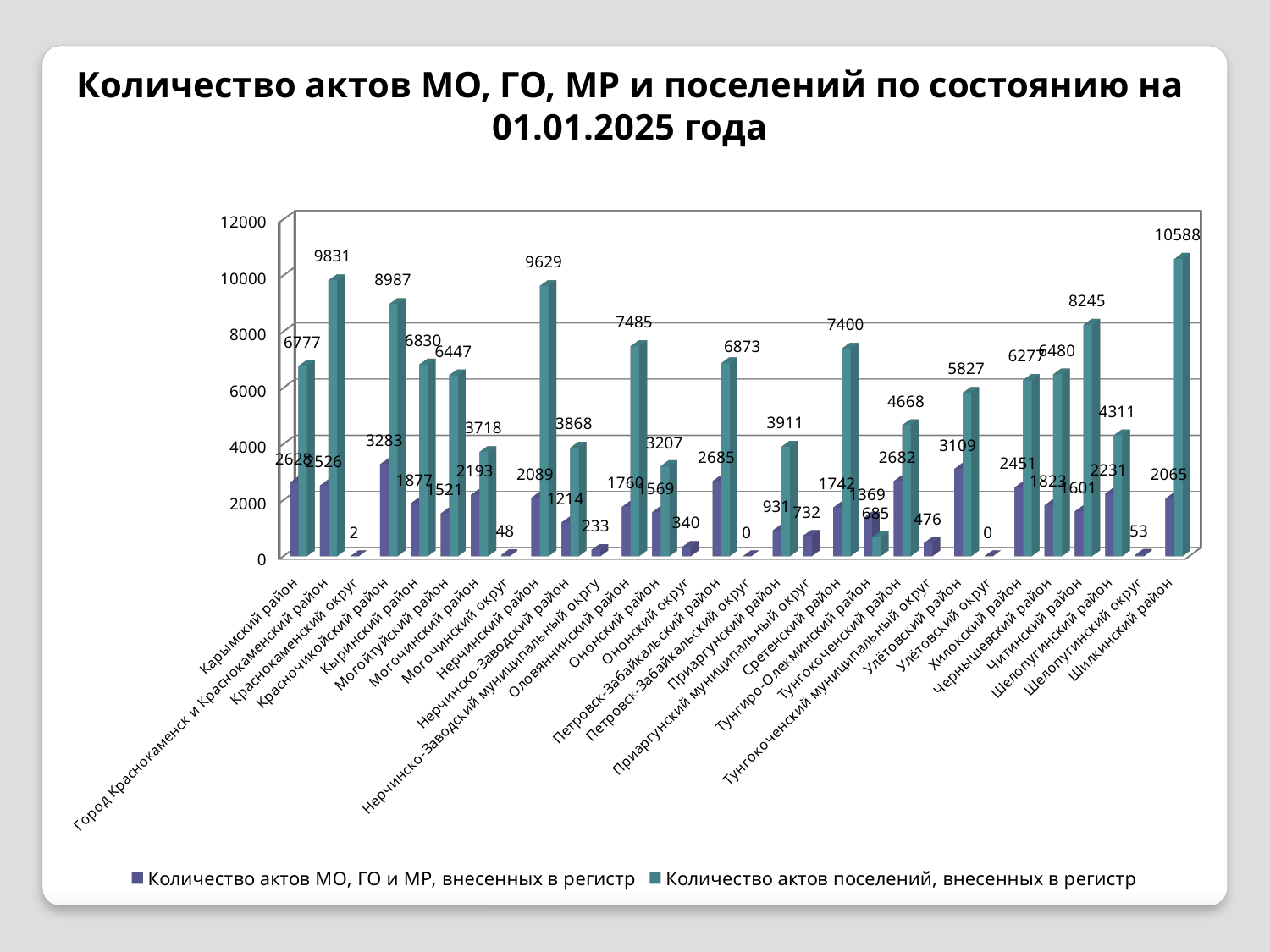
Which category has the highest value for 'Количество актов МО, ГО и МР, внесенных в регистр'? Красночикойский район How many series does the legend list? 2 Which is larger: the 'Количество актов поселений, внесенных в регистр' value for Читинский район or for Оловяннинский район? Читинский район How many categories are shown on the x axis? 30 What is the value of 'Количество актов поселений, внесенных в регистр' for Шилкинский район? 10588 What is the value of 'Количество актов МО, ГО и МР, внесенных в регистр' for Улётовский район? 3109 Which category has the highest value for 'Количество актов поселений, внесенных в регистр'? Шилкинский район What kind of chart is shown on the slide? bar chart What is the title of the chart? Количество актов МО, ГО, МР и поселений по состоянию на 01.01.2025 года What is the difference between the 'Количество актов поселений, внесенных в регистр' values for Шилкинский район and Город Краснокаменск и Краснокаменский район? 757 What is the value of 'Количество актов МО, ГО и МР, внесенных в регистр' for Красночикойский район? 3283 What is the value of 'Количество актов поселений, внесенных в регистр' for Нерчинский район? 9629